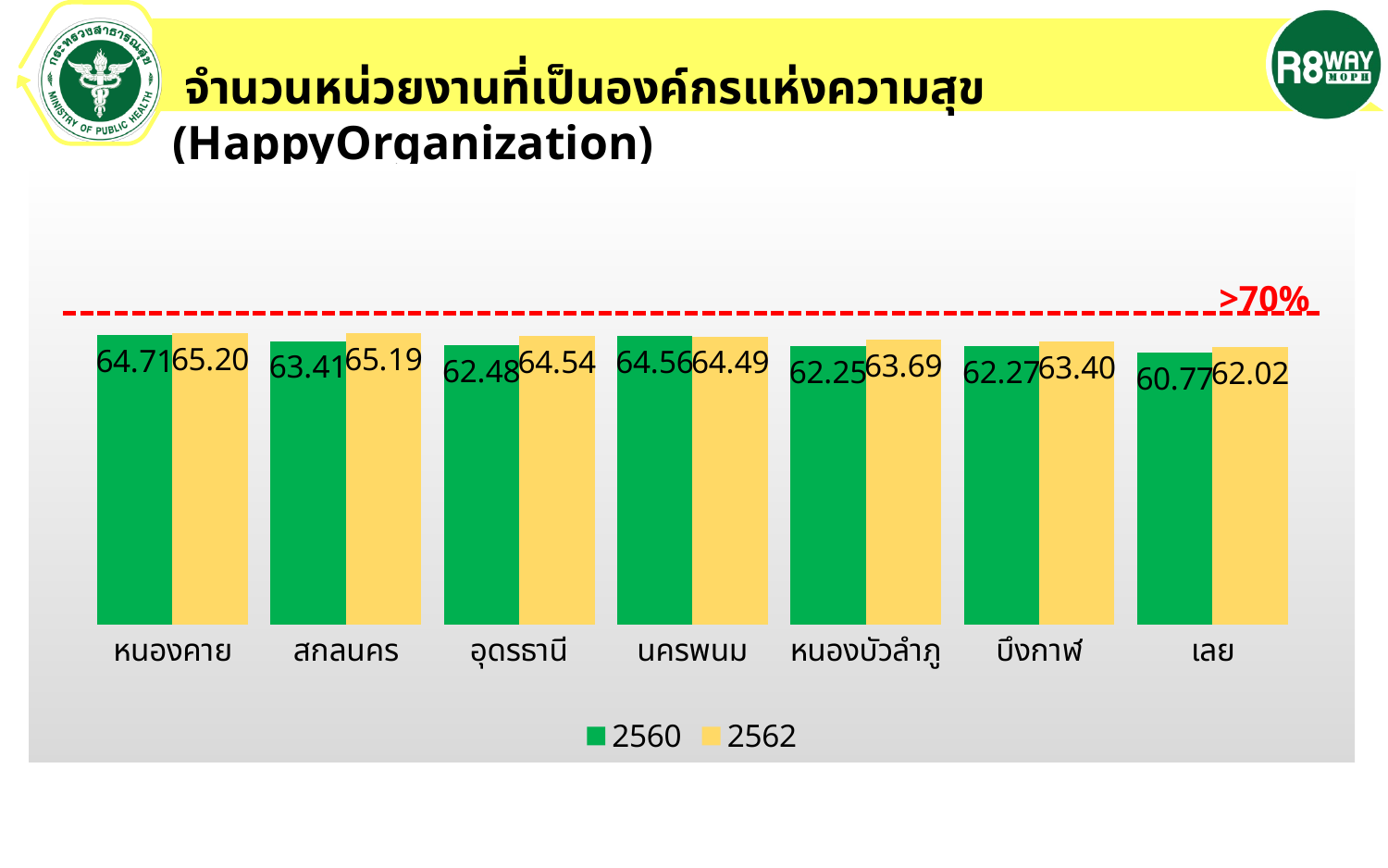
Which province has the lowest value in the 2562 series? เลย How many series does the legend list? 2 Which is larger for อุดรธานี, the 2560 value or the 2562 value? 2562 What is the value for เลย in the 2560 series? 60.77 Is the 2562 value for บึงกาฬ greater or less than 70? less Which province has the highest value in the 2560 series? หนองคาย What kind of chart is shown on the slide? bar chart What is the value for หนองคาย in the 2560 series? 64.71 What is the difference between the 2562 and 2560 values for สกลนคร? 1.78 What is the value for สกลนคร in the 2562 series? 65.19 What is the value for หนองบัวลำภู in the 2562 series? 63.69 How many provinces are shown on the x axis? 7